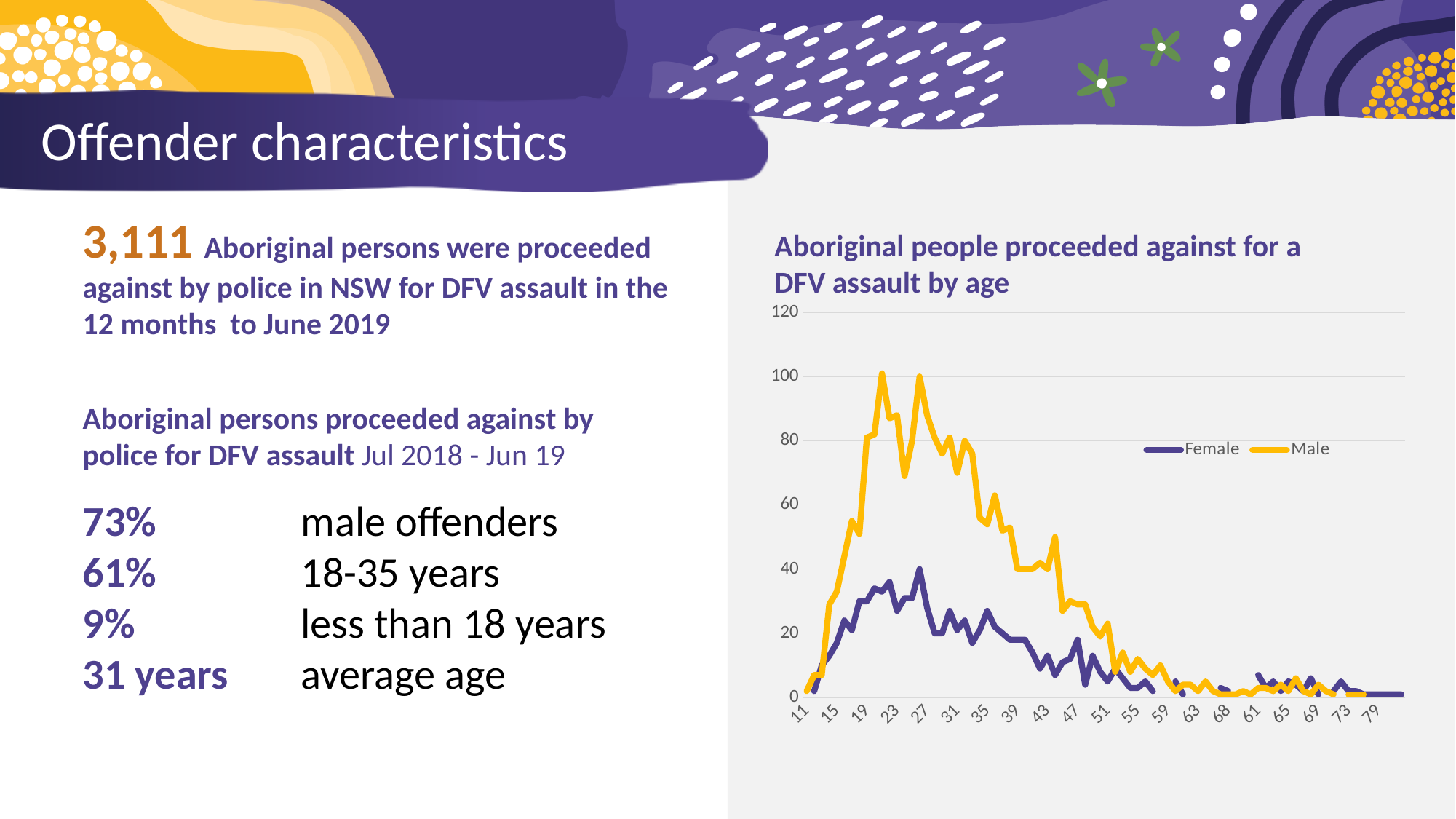
What colour is the Male line in the chart? yellow How many series does the legend of the chart list? 2 Which series reaches the highest value in the chart? Male Is the Female value at age 27 greater or less than 60? less Is the Female value at age 19 greater or less than 40? less Do the Male values generally rise or fall from age 35 to age 59? fall What is the highest value shown on the chart's vertical axis? 120 What kind of chart is shown on the slide? line chart Is the Male value at age 27 greater or less than 80? greater What are the two series named in the chart legend? Female and Male At age 27, which series has the larger value, Female or Male? Male